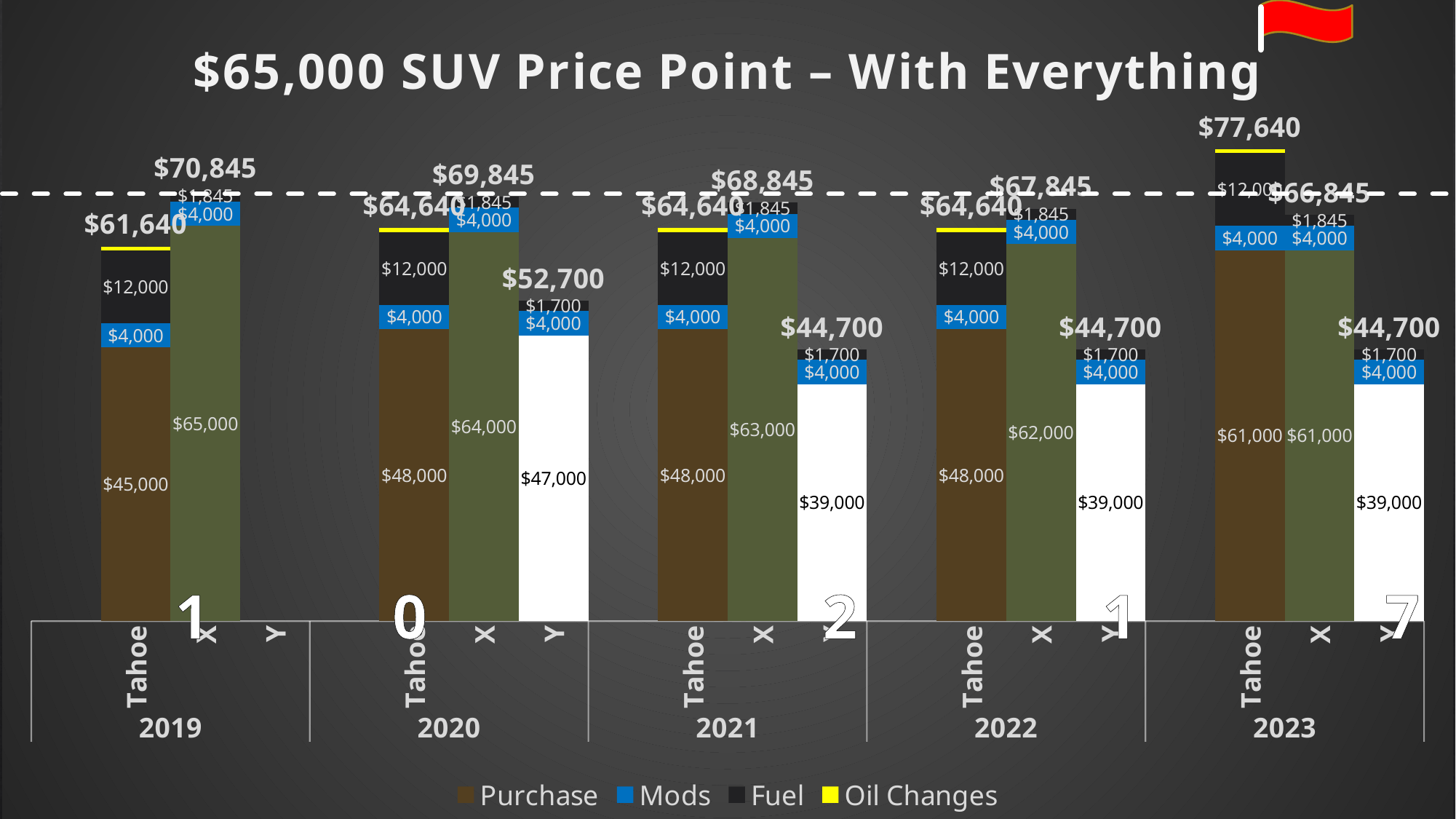
What kind of chart is shown on the slide? Stacked bar chart What are the series listed in the legend? Purchase, Mods, Fuel, Oil Changes What is the Purchase value for the Tahoe in 2019? $45,000 What is the Fuel value for the Tahoe in 2022? $12,000 What is the Fuel value for X in 2021? $1,845 What is the difference between the Purchase value for X in 2019 and X in 2023? $4,000 What is the total of the stacked bar for the Tahoe in 2023? $77,640 How many series does the legend list? 4 What is the Purchase value for Y in 2020? $47,000 Which bar has the highest total on the chart? Tahoe in 2023 Which vehicle has the lowest total in 2020? Y Which has the larger total in 2020, the Tahoe or X? X